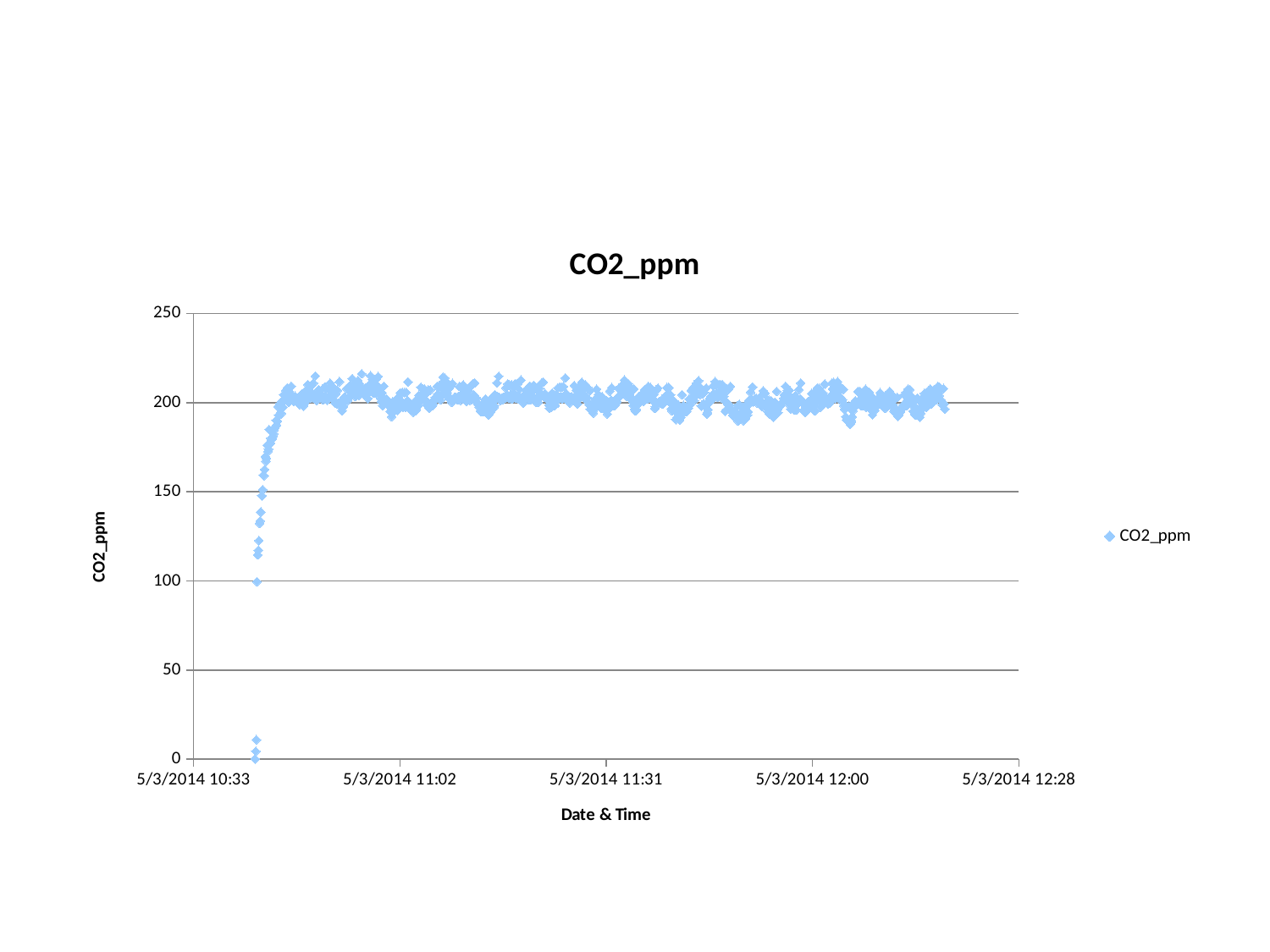
Do the values rise or fall along the x axis between the first points and 5/3/2014 11:02? rise What is the label of the x axis? Date & Time Which is larger: the value of the first plotted point near 5/3/2014 10:33 or the values plotted around 5/3/2014 11:31? the values around 5/3/2014 11:31 Are the plotted values around 5/3/2014 11:31 greater or less than 150? greater Are the plotted values around 5/3/2014 11:02 greater or less than 100? greater What is the highest tick value shown on the y axis? 250 What is the title of the chart? CO2_ppm What kind of chart is shown on the slide? scatter chart How many series does the legend list? 1 Are the earliest plotted points, just after 5/3/2014 10:33, greater or less than 50? less